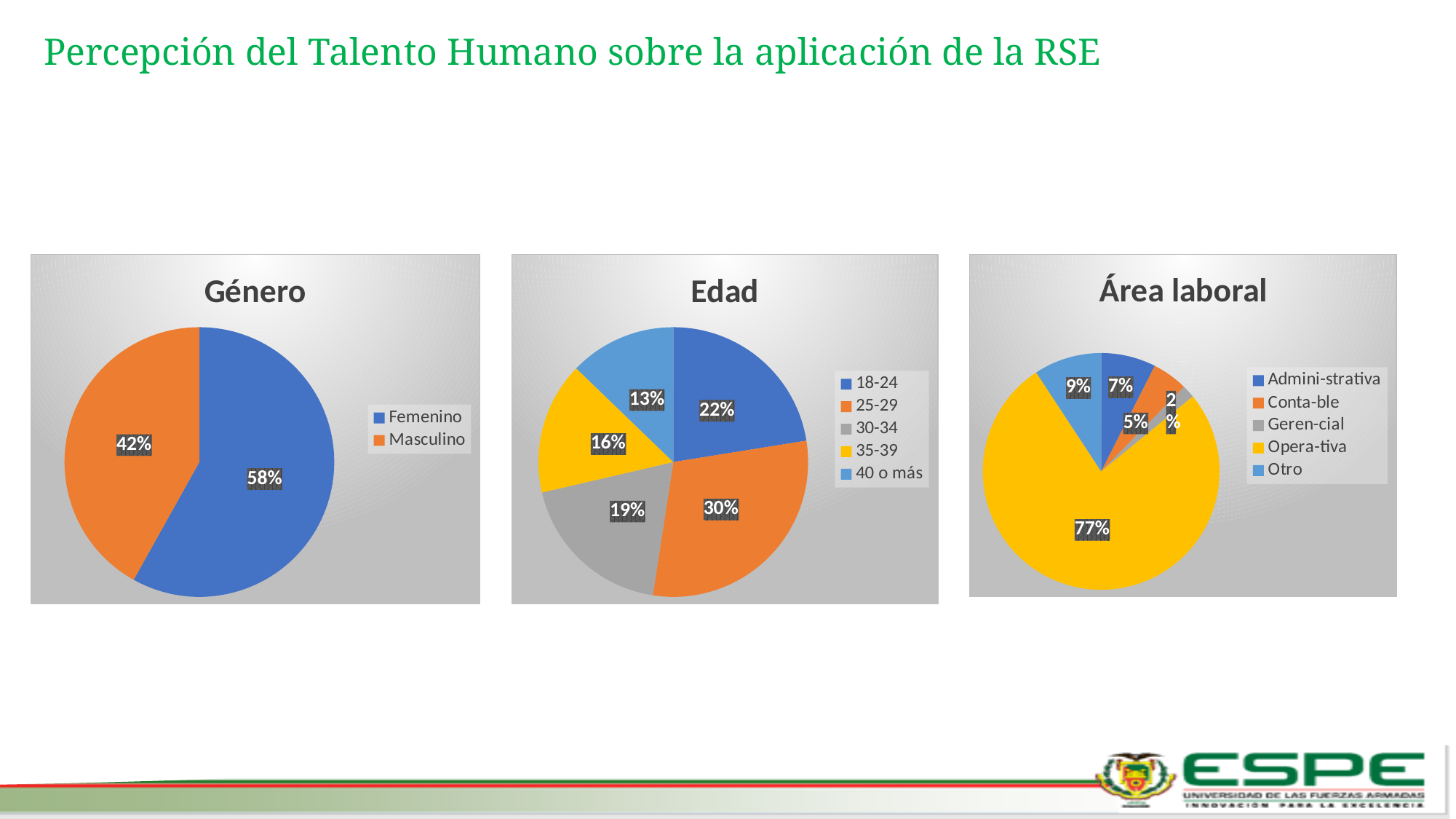
In the 'Área laboral' chart, which area has the largest share? Opera-tiva In the 'Edad' chart, how many categories does the legend list? 5 In the 'Edad' chart, what is the difference between the 25-29 and 18-24 shares? 8% In the 'Área laboral' chart, what is the value for Otro? 9% In the 'Edad' chart, which age group has the smallest share? 40 o más In the 'Edad' chart, what is the value for 30-34? 19% In the 'Género' chart, what is the value for Masculino? 42% In the 'Edad' chart, which age group has the largest share? 25-29 In the 'Género' chart, what share of the pie is Femenino? 58% How many pie charts are on the slide? 3 In the 'Género' chart, what type of chart is shown? pie chart In the 'Área laboral' chart, which is larger, Admini-strativa or Conta-ble? Admini-strativa